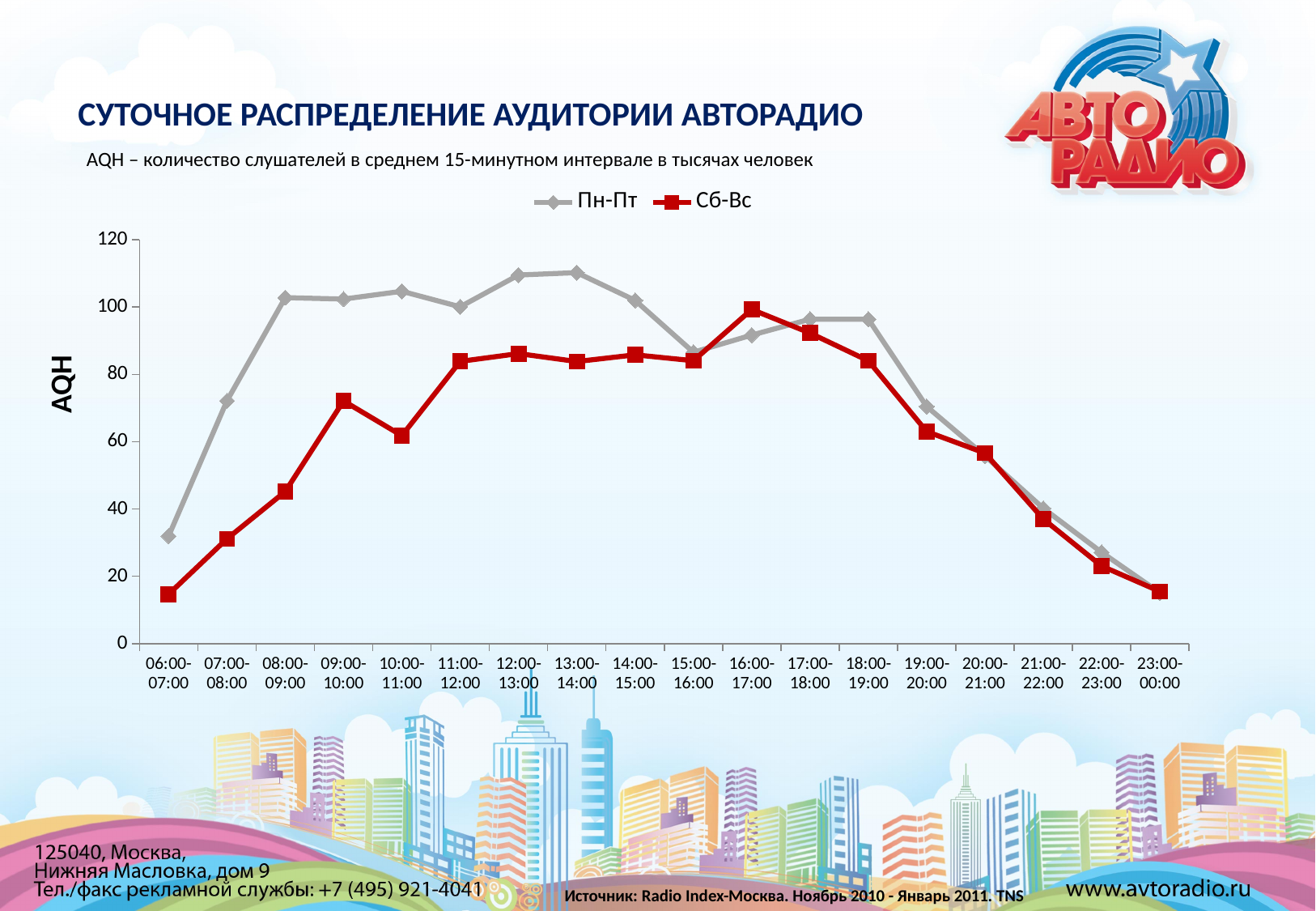
Which time interval has the lowest value for Пн-Пт? 23:00-00:00 How many time intervals are shown on the x axis? 18 How many series does the legend list? 2 At 16:00-17:00, which series has the larger value, Пн-Пт or Сб-Вс? Сб-Вс Is the value for Сб-Вс at 06:00-07:00 greater or less than 20? less Which time interval has the highest value for Сб-Вс? 16:00-17:00 What kind of chart is shown on the slide? line chart Is the value for Пн-Пт at 08:00-09:00 greater or less than 100? greater Do the values for Пн-Пт rise or fall from 18:00-19:00 to 23:00-00:00? fall At 08:00-09:00, which series has the larger value, Пн-Пт or Сб-Вс? Пн-Пт What is the label on the y axis of the chart? AQH